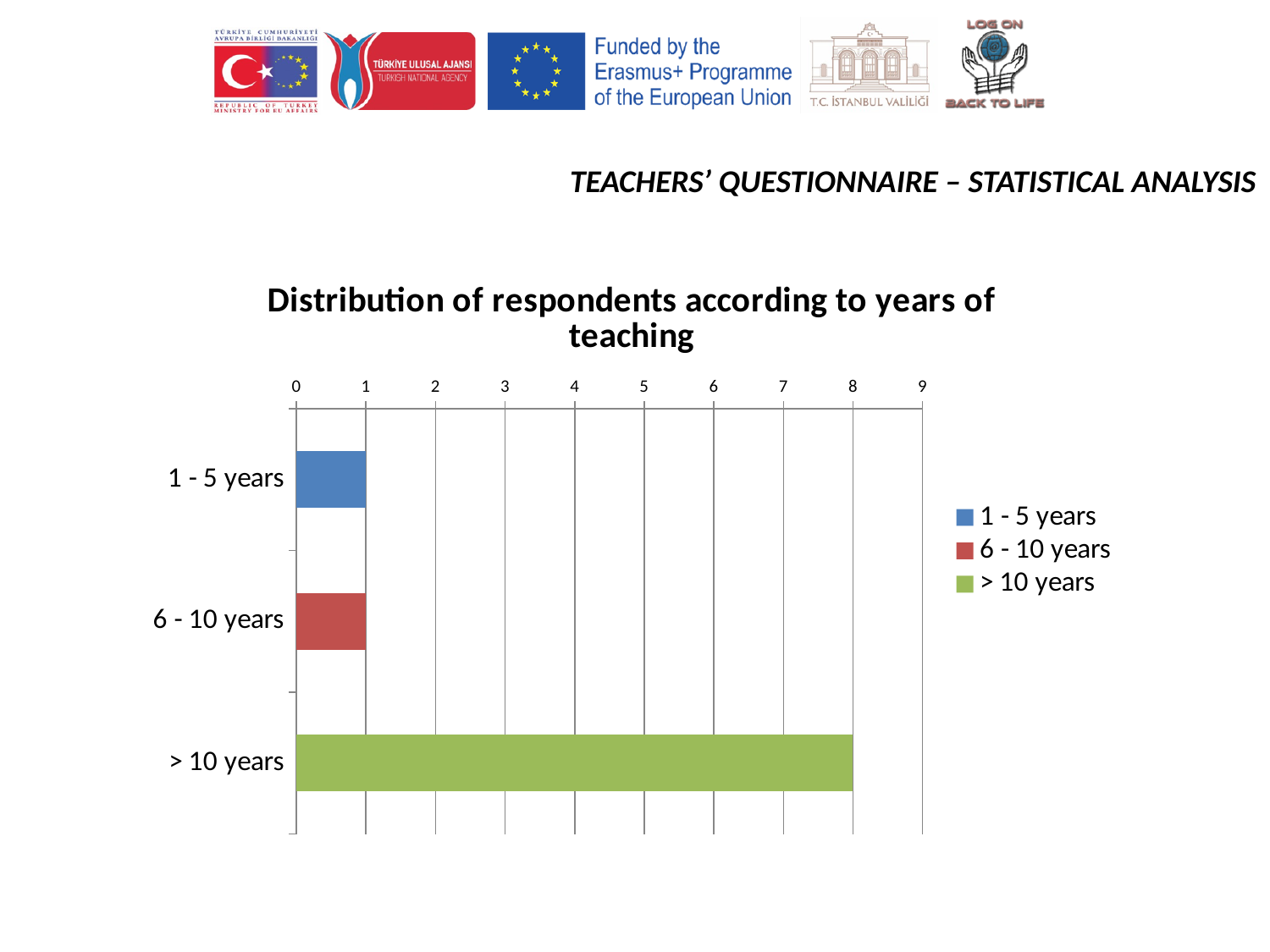
How many categories are plotted in the chart? 3 How many entries does the legend list? 3 Which is larger, the value for '> 10 years' or the value for '6 - 10 years'? > 10 years What is the value for the '1 - 5 years' category? 1 What colour is the bar for '> 10 years'? green What kind of chart is shown on the slide? bar chart What is the title of the chart? Distribution of respondents according to years of teaching What is the value for the '> 10 years' category? 8 What is the difference between the values for '> 10 years' and '1 - 5 years'? 7 Is the value for '> 10 years' greater or less than 5? greater Which category has the highest value? > 10 years What is the value for the '6 - 10 years' category? 1